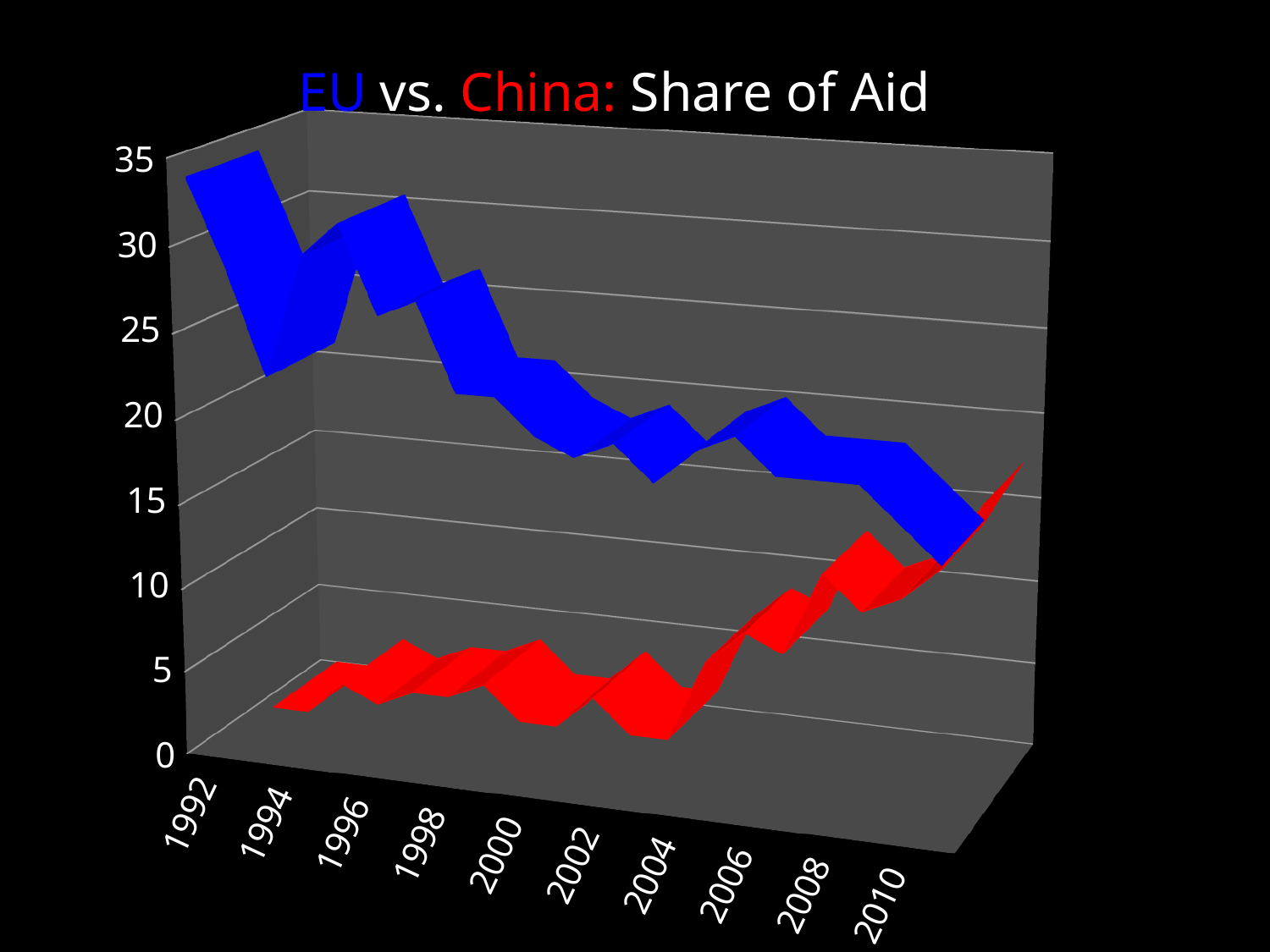
Which colour represents the EU series? blue Is the EU value for 1992 greater or less than 30? greater Is the China value for 1992 greater or less than 5? less What is the title of the chart? EU vs. China: Share of Aid In which year is the EU share of aid highest? 1992 Which series has the larger value in 1992, EU or China? EU How many series are plotted on the chart? 2 How many year labels are shown on the x axis? 10 Does the China share of aid rise or fall from 2004 to 2010? rise In which year is the China share of aid highest? 2011 What kind of chart is shown on the slide? line chart Does the EU share of aid rise or fall from 1992 to 2010? fall